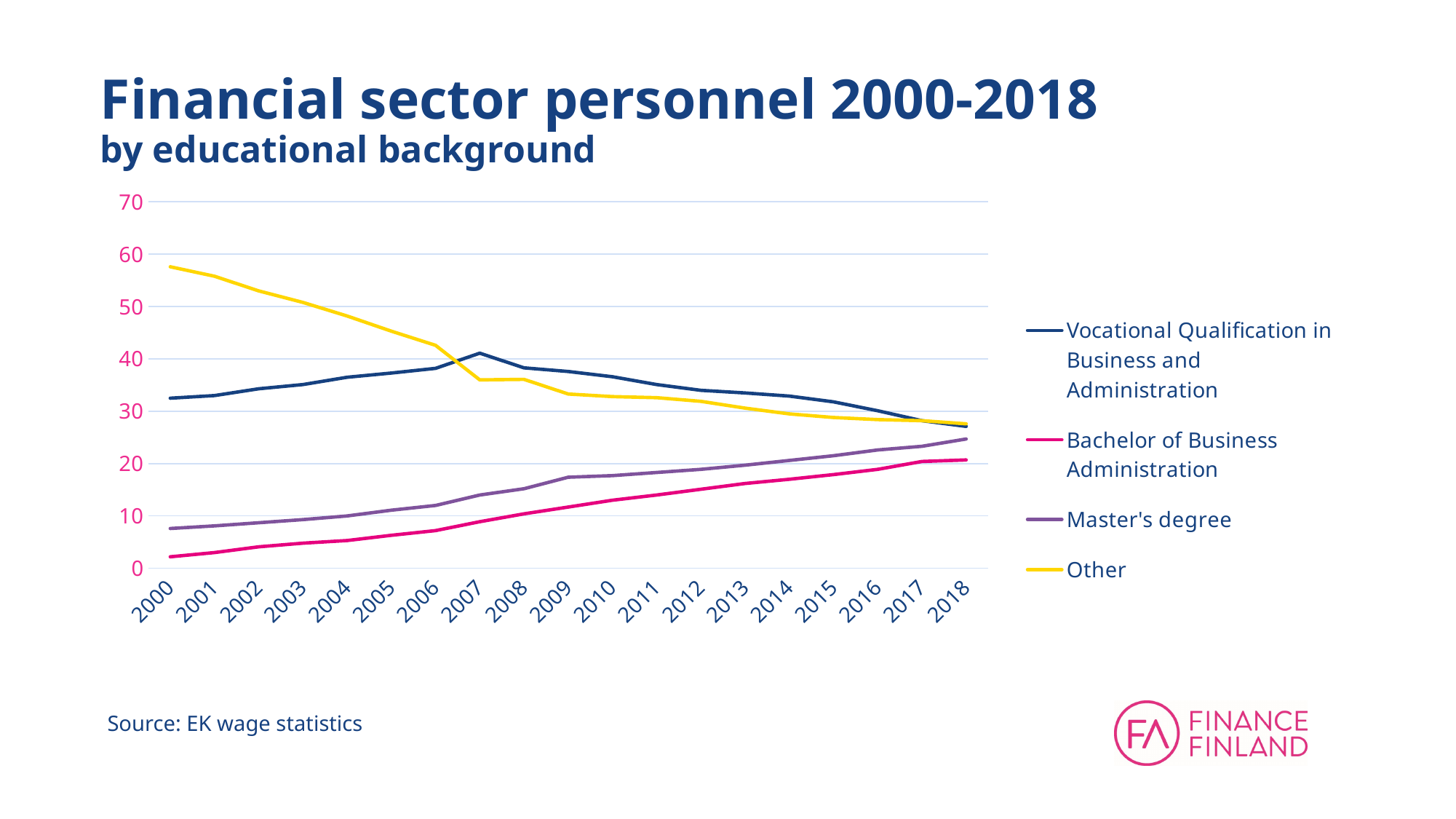
Does the Bachelor of Business Administration series rise or fall from 2000 to 2018? Rise Does the Other series rise or fall from 2000 to 2018? Fall Which series has the lowest value in 2000? Bachelor of Business Administration Is the value for Other in 2018 greater or less than 30? less Is the value for Master's degree in 2000 greater or less than 10? less Which series has the highest value in 2000? Other Is the value for Other in 2000 greater or less than 50? greater What kind of chart is shown on the slide? Line chart In 2018, which is larger: Master's degree or Bachelor of Business Administration? Master's degree Which series has the lowest value in 2018? Bachelor of Business Administration How many series does the legend list? 4 How many years are plotted along the x axis? 19